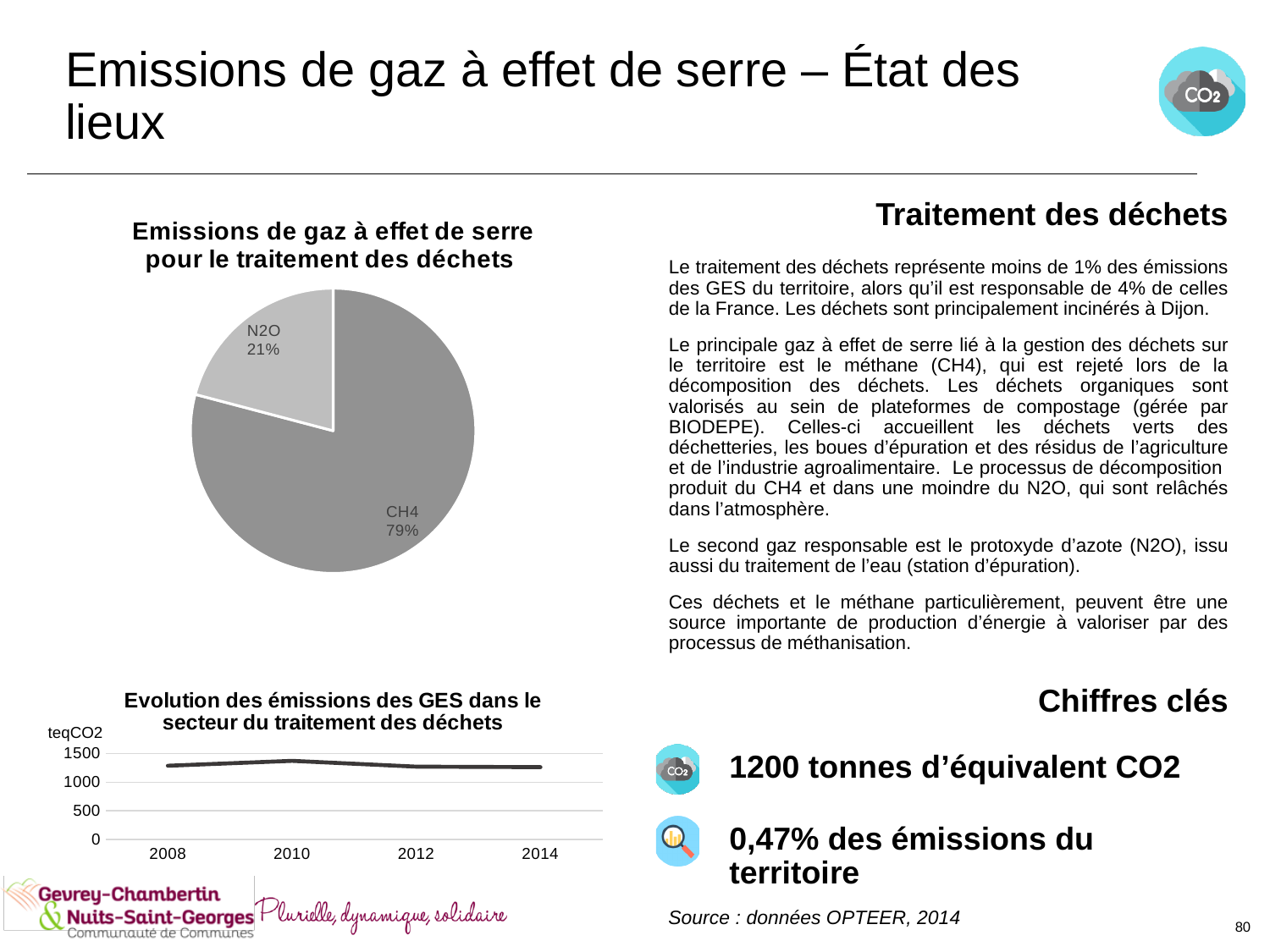
In the pie chart 'Emissions de gaz à effet de serre pour le traitement des déchets', what share does N2O represent? 21% In the chart 'Evolution des émissions des GES dans le secteur du traitement des déchets', is the value for 2010 greater or less than 1000? greater In the chart 'Evolution des émissions des GES dans le secteur du traitement des déchets', is the value for 2014 greater or less than 1500? less In the pie chart 'Emissions de gaz à effet de serre pour le traitement des déchets', which gas has the largest slice? CH4 What type of chart is 'Evolution des émissions des GES dans le secteur du traitement des déchets'? Line chart In the pie chart 'Emissions de gaz à effet de serre pour le traitement des déchets', which gas has the smallest slice? N2O In the chart 'Evolution des émissions des GES dans le secteur du traitement des déchets', what is the first year shown on the x axis? 2008 What type of chart is the upper-left chart on the slide? Pie chart In the pie chart 'Emissions de gaz à effet de serre pour le traitement des déchets', how many slices are there? 2 In the pie chart 'Emissions de gaz à effet de serre pour le traitement des déchets', what is the difference in percentage points between the CH4 and N2O shares? 58 percentage points In the chart 'Evolution des émissions des GES dans le secteur du traitement des déchets', what unit is shown on the y axis? teqCO2 In the pie chart 'Emissions de gaz à effet de serre pour le traitement des déchets', what share does CH4 represent? 79%